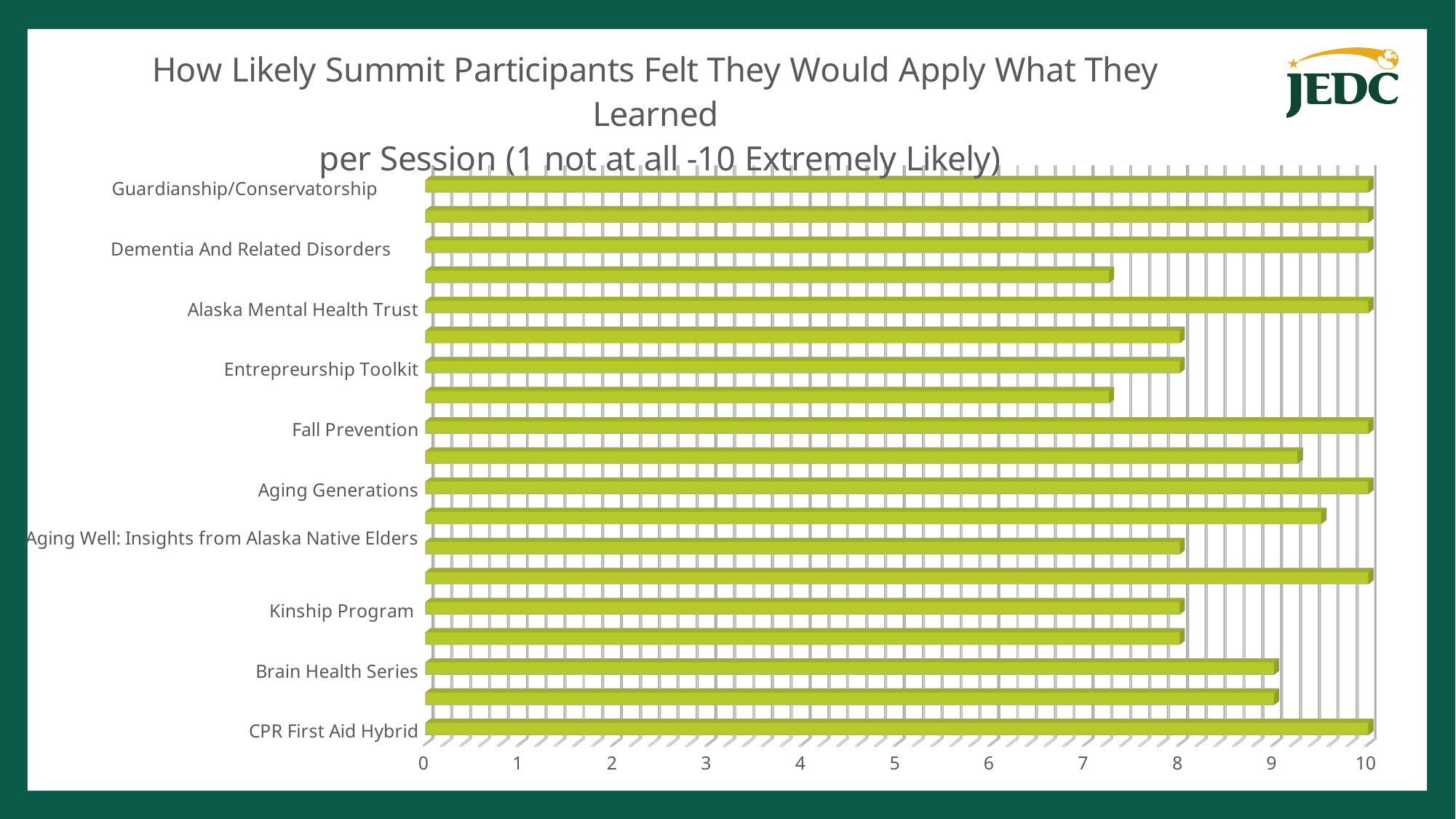
What is the value for Alaska Mental Health Trust? 10 Is the value for Entrepreurship Toolkit greater or less than 9? less Which has the higher value, Aging Generations or Aging Well: Insights from Alaska Native Elders? Aging Generations Which has the higher value, Fall Prevention or Entrepreurship Toolkit? Fall Prevention What is the highest value shown on the horizontal axis? 10 What is the value for Guardianship/Conservatorship? 10 What is the value for CPR First Aid Hybrid? 10 What kind of chart is shown on the slide? bar chart Is the value for Aging Well: Insights from Alaska Native Elders greater or less than 7? greater Is the value for Brain Health Series greater or less than 8? greater How many bars are plotted in the chart? 19